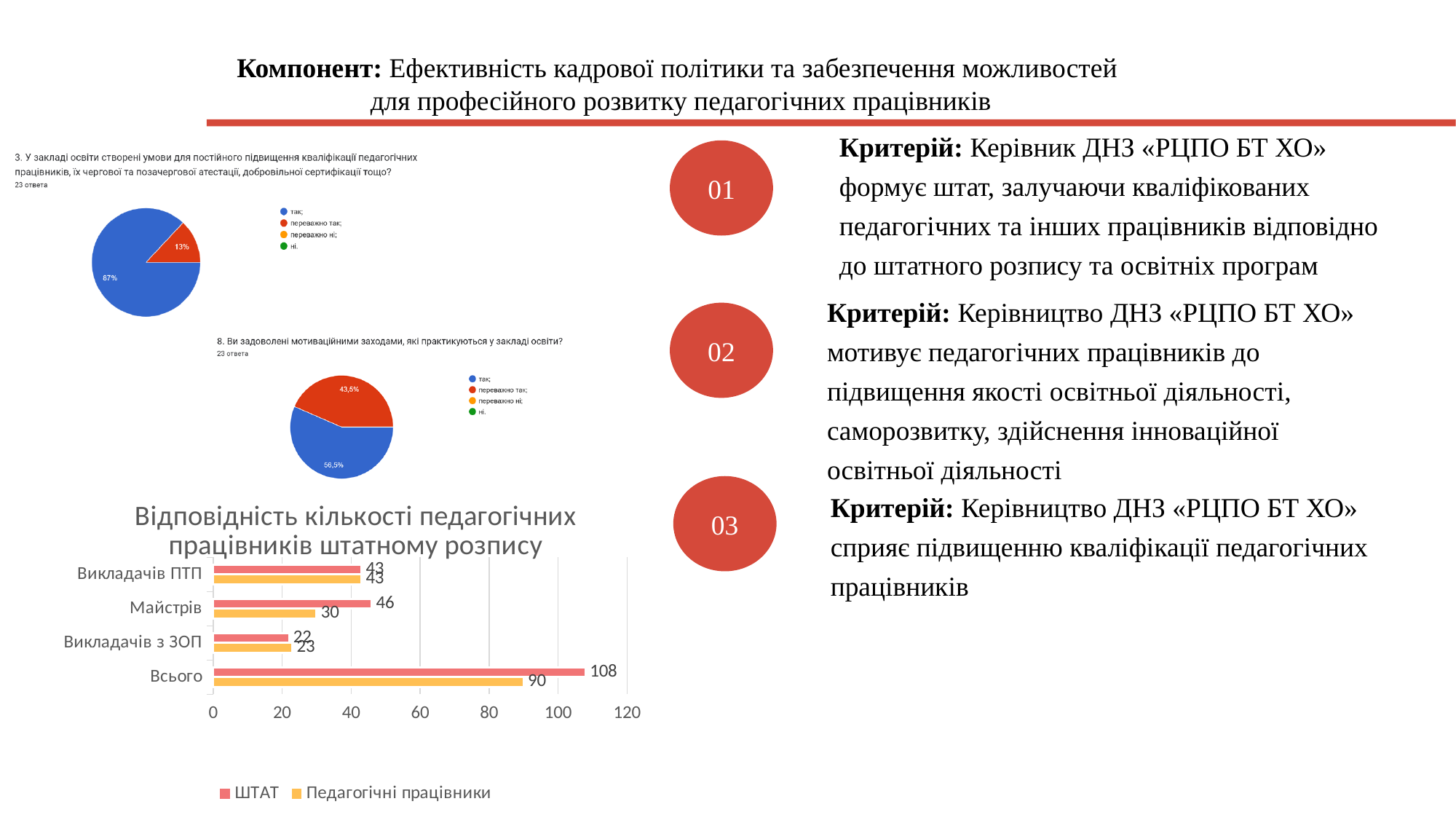
In the bar chart 'Відповідність кількості педагогічних працівників штатному розпису', what is the Педагогічні працівники value for Всього? 90 In the bar chart 'Відповідність кількості педагогічних працівників штатному розпису', what is the Педагогічні працівники value for Викладачів з ЗОП? 23 How many categories are shown in the bar chart 'Відповідність кількості педагогічних працівників штатному розпису'? 4 In the middle pie chart (question 8 about satisfaction with motivational measures), what share of responses is 'переважно так'? 43,5% How many series does the legend of the bar chart 'Відповідність кількості педагогічних працівників штатному розпису' list? 2 In the bar chart 'Відповідність кількості педагогічних працівників штатному розпису', what is the difference between the ШТАТ and Педагогічні працівники values for Всього? 18 In the middle pie chart (question 8 about satisfaction with motivational measures), which response has the larger share: 'так' or 'переважно так'? так In the bar chart 'Відповідність кількості педагогічних працівників штатному розпису', what is the ШТАТ value for Майстрів? 46 In the top pie chart (question 3 about conditions for raising qualifications), what share of responses is 'так'? 87% In the bar chart 'Відповідність кількості педагогічних працівників штатному розпису', which category has the lowest ШТАТ value? Викладачів з ЗОП In the bar chart 'Відповідність кількості педагогічних працівників штатному розпису', is the ШТАТ value for Майстрів larger or the Педагогічні працівники value for Майстрів? ШТАТ What type of chart is 'Відповідність кількості педагогічних працівників штатному розпису'? Bar chart